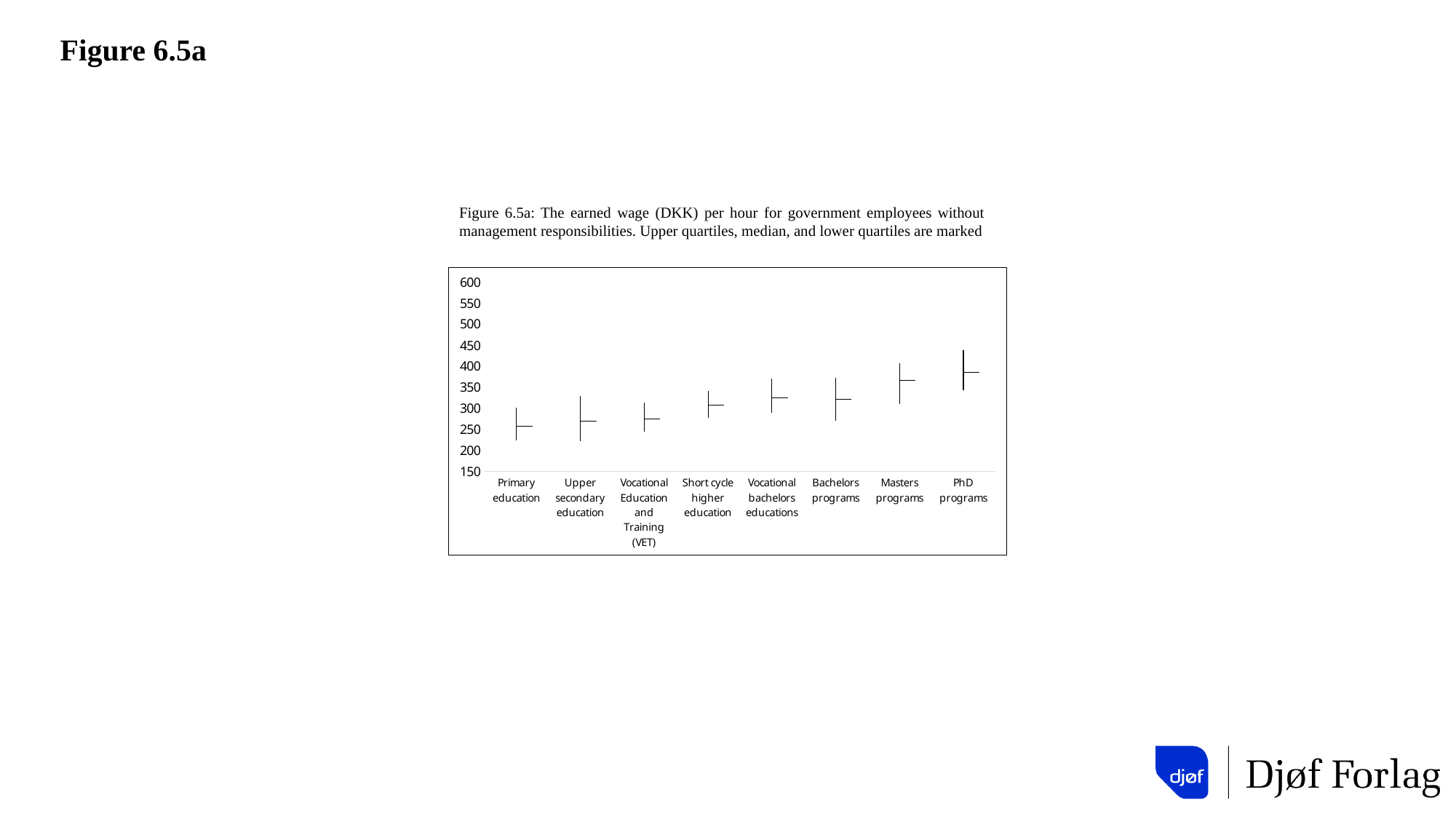
Which education category has the lowest median hourly wage? Primary education Is the median wage for Masters programs greater or less than 350? greater Is the median wage for PhD programs greater or less than 350? greater Is the median wage for Vocational bachelors educations greater or less than 300? greater Do the median wages generally rise or fall moving from Primary education to PhD programs along the x axis? Rise What kind of chart is shown on the slide? High-low (stock-style) chart showing quartiles and median Which has the larger median wage, Masters programs or Bachelors programs? Masters programs Which education category has the highest median hourly wage? PhD programs How many education categories are shown on the x axis of the chart? 8 What is the lowest value shown on the y axis of the chart? 150 What unit of wage does the figure caption say is plotted? DKK per hour